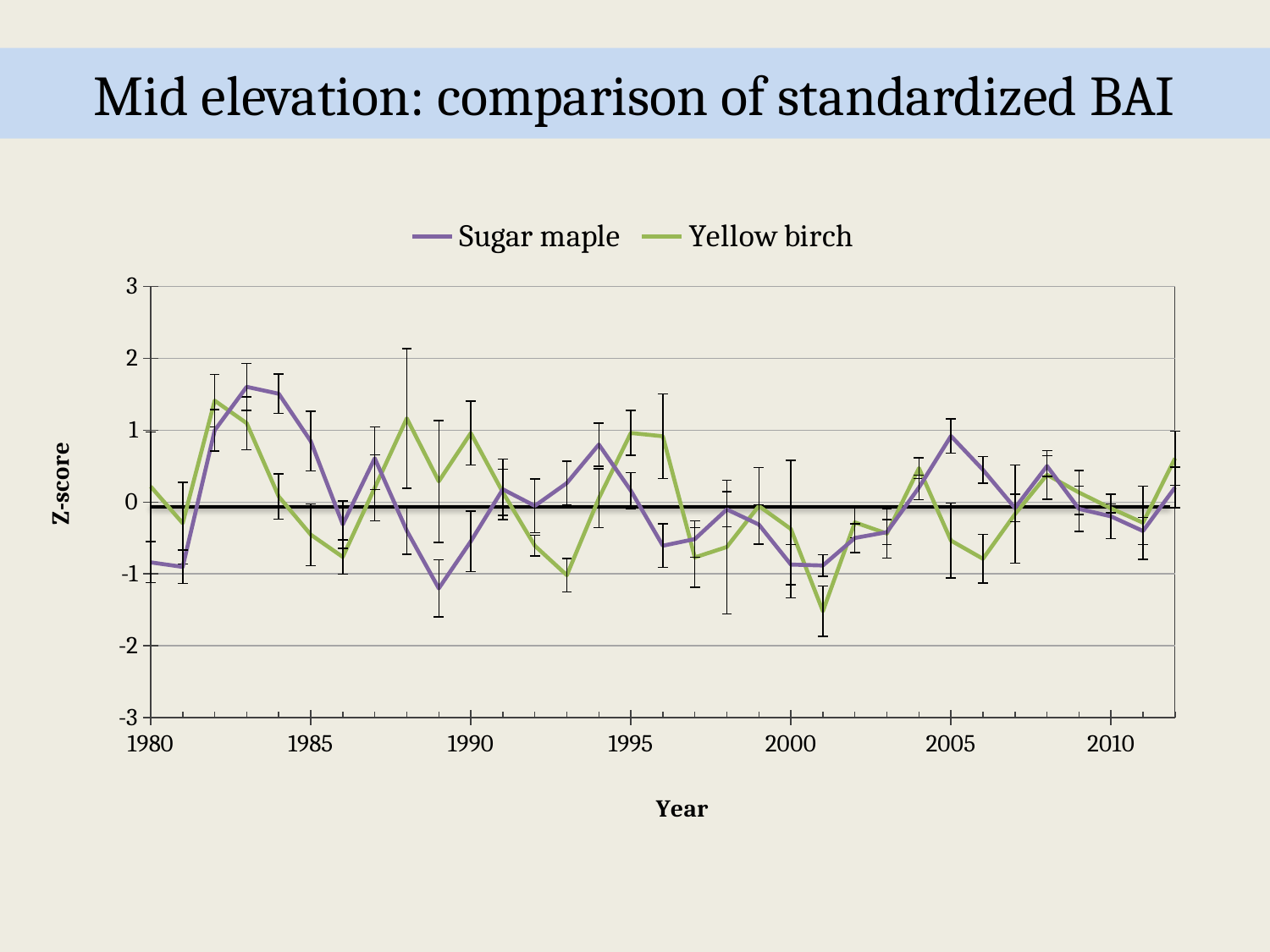
Is the Sugar maple value in 2005 greater or less than 0? greater How many series does the legend list? 2 In 1988, which series has the higher value, Sugar maple or Yellow birch? Yellow birch What kind of chart is shown on the slide? line chart What is the title of the chart? Mid elevation: comparison of standardized BAI Is the Sugar maple value in 1983 greater or less than 1? greater What label is on the vertical axis of the chart? Z-score In which year does the Yellow birch series reach its lowest value? 2001 In 1993, which series has the higher value, Sugar maple or Yellow birch? Sugar maple In which year does the Sugar maple series reach its highest value? 1983 In which year does the Sugar maple series reach its lowest value? 1989 Is the Yellow birch value in 2001 greater or less than -1? less